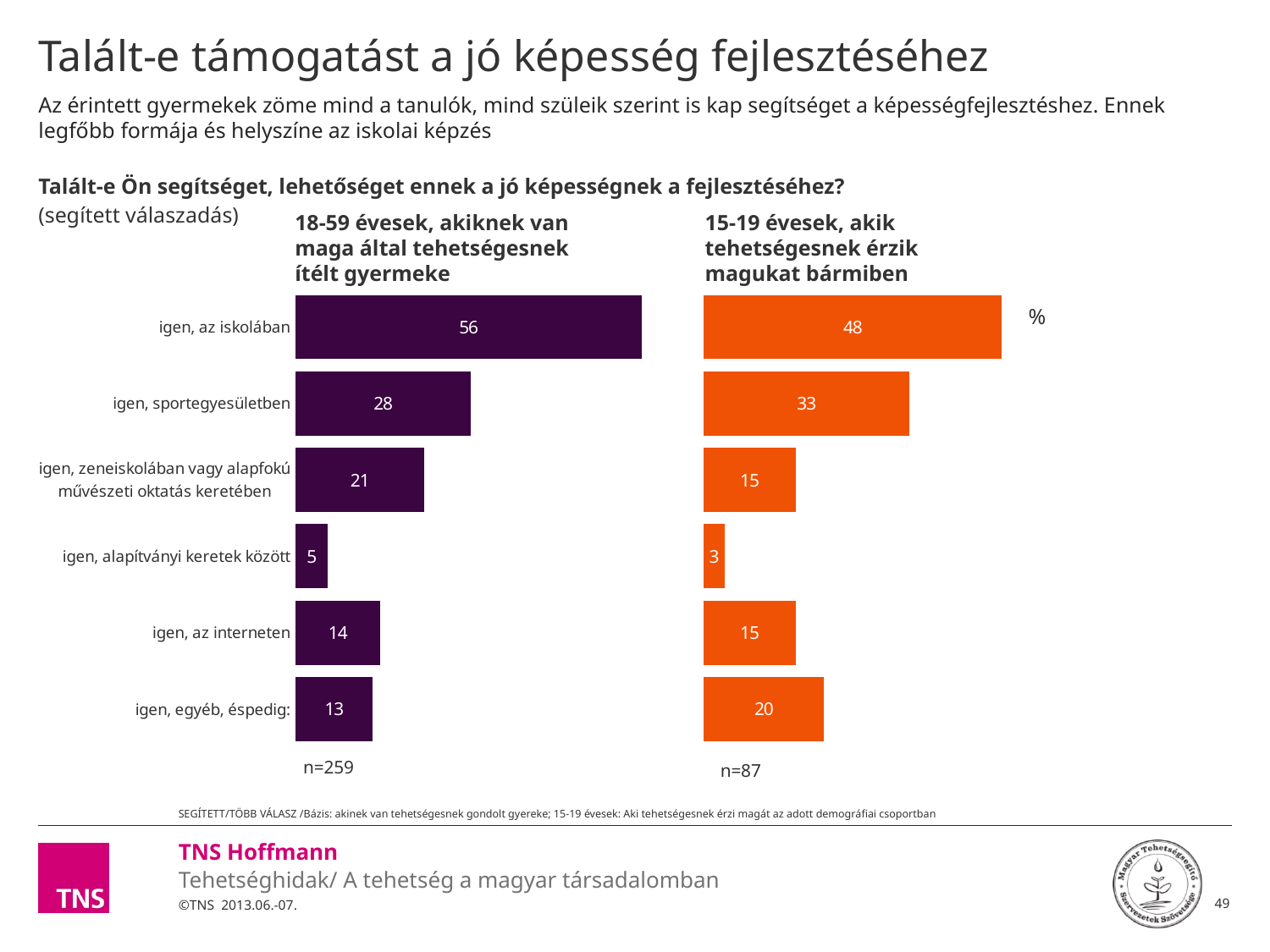
What type of chart is the right chart (15-19 évesek)? bar chart What is the sample size (n) shown under the left chart (18-59 évesek)? n=259 What is the difference between the "igen, az iskolában" value in the left chart (18-59 évesek) and in the right chart (15-19 évesek)? 8 In the left chart (18-59 évesek, akiknek van maga által tehetségesnek ítélt gyermeke), what is the value for "igen, az iskolában"? 56 Which chart has the larger value for "igen, egyéb, éspedig:", the left chart (18-59 évesek) or the right chart (15-19 évesek)? the right chart (15-19 évesek) In the left chart (18-59 évesek), what is the difference between "igen, az iskolában" and "igen, sportegyesületben"? 28 In the right chart (15-19 évesek), which category has the highest value? igen, az iskolában In the right chart (15-19 évesek), what is the value for "igen, egyéb, éspedig:"? 20 In the left chart (18-59 évesek), which category has the lowest value? igen, alapítványi keretek között In the left chart (18-59 évesek), which is larger: "igen, az interneten" or "igen, zeneiskolában vagy alapfokú művészeti oktatás keretében"? igen, zeneiskolában vagy alapfokú művészeti oktatás keretében In the right chart (15-19 évesek, akik tehetségesnek érzik magukat bármiben), what is the value for "igen, sportegyesületben"? 33 How many categories are shown in the left chart (18-59 évesek)? 6